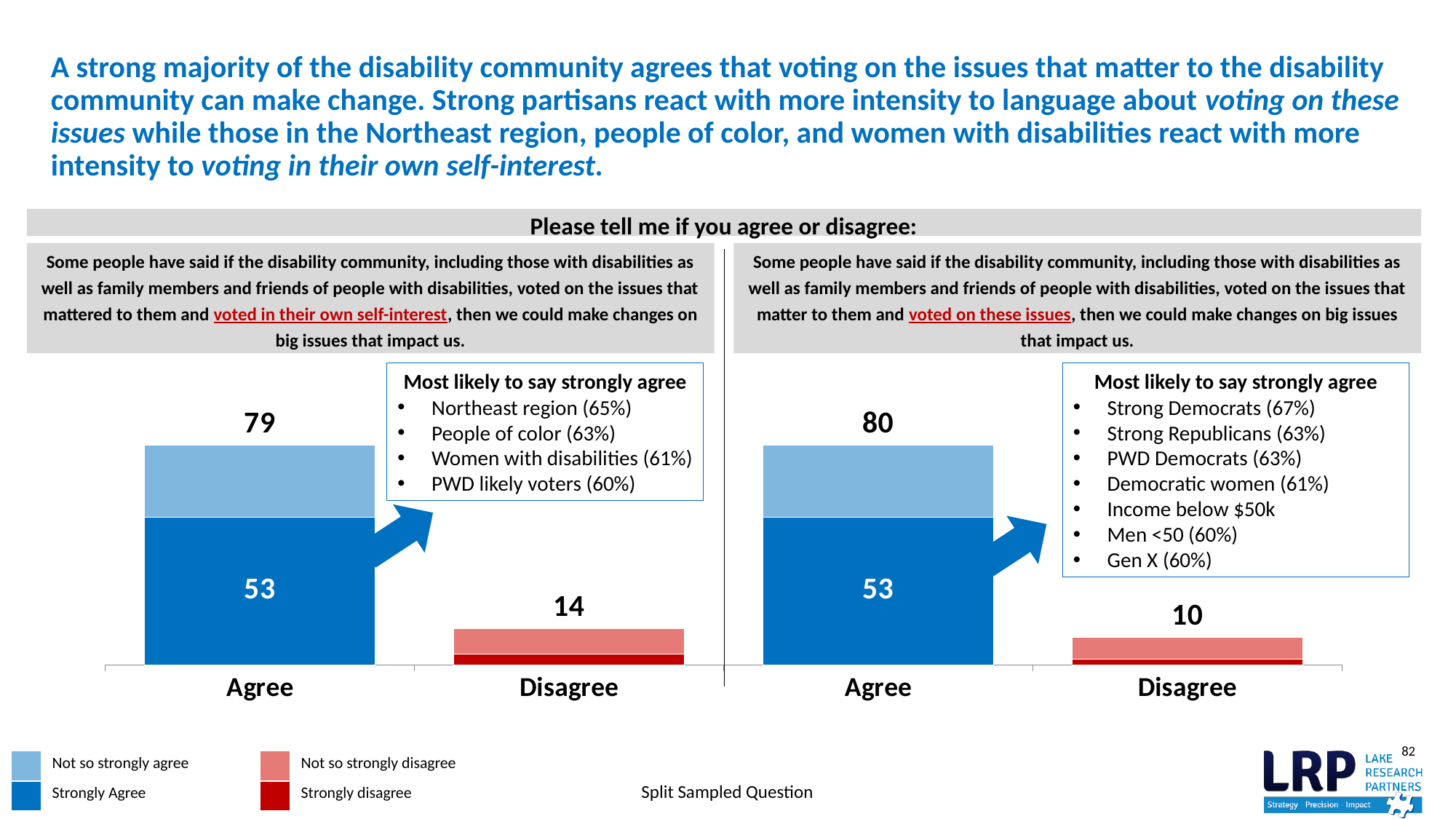
How many categories are shown on the x axis of the right chart (voted on these issues)? 2 In the right chart (voted on these issues), what is the total value shown for Agree? 80 Which chart shows the larger Disagree total, the left chart or the right chart? The left chart In the left chart (voted in their own self-interest), what is the total value shown for Agree? 79 In the right chart (voted on these issues), what is the total value shown for Disagree? 10 In the left chart (voted in their own self-interest), which category has the higher total, Agree or Disagree? Agree In the left chart (voted in their own self-interest), what is the value labeled for Strongly Agree within the Agree bar? 53 In the left chart (voted in their own self-interest), what is the difference between the Agree total and the Disagree total? 65 In the right chart (voted on these issues), what is the difference between the Agree total and the Disagree total? 70 What type of chart is used on the left side of the slide? Stacked bar chart In the left chart (voted in their own self-interest), what is the total value shown for Disagree? 14 How many entries does the legend at the bottom of the slide list? 4